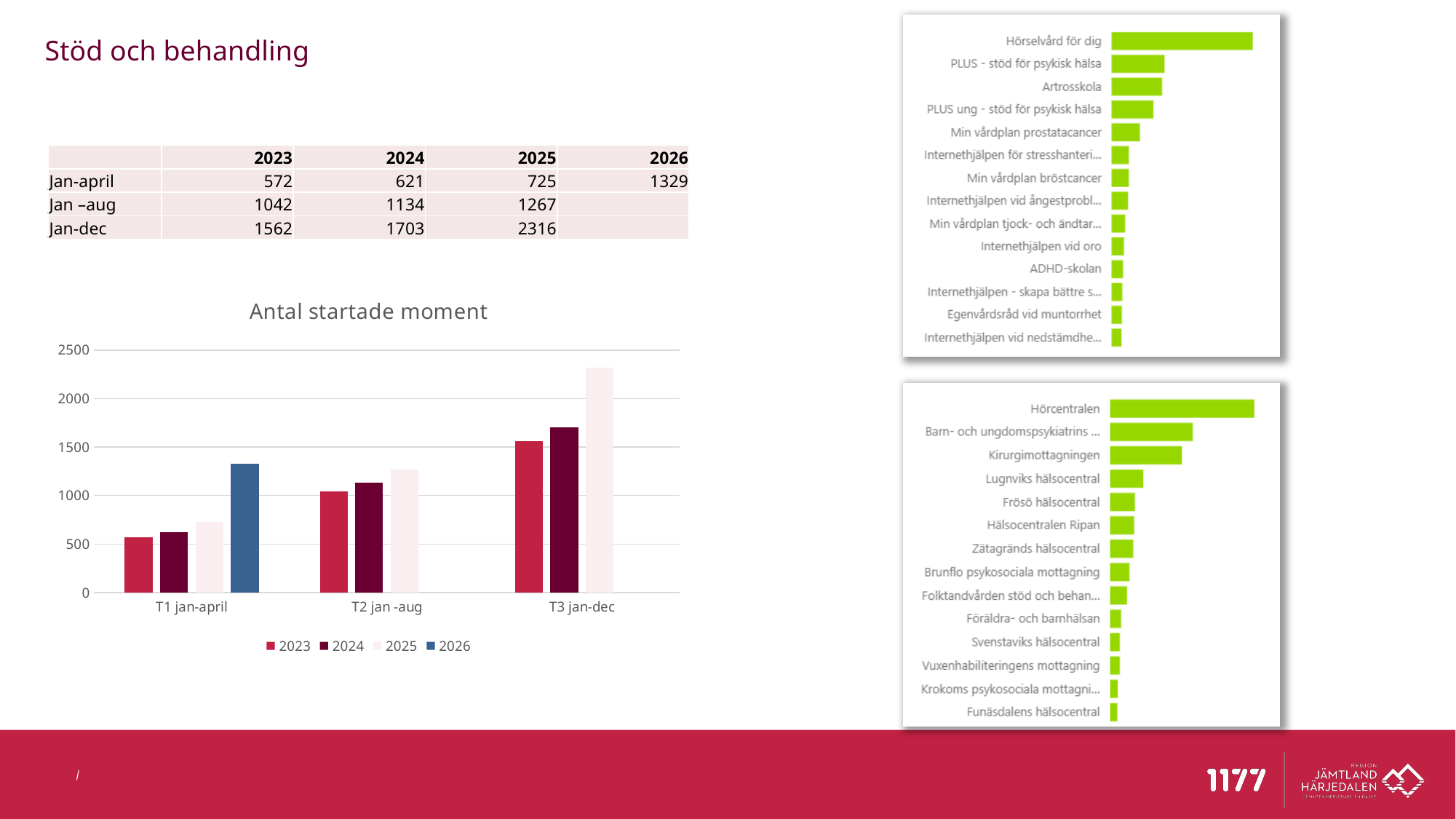
In the 'Antal startade moment' chart, what is the difference between 2025 and 2024 in T3 jan-dec? 613 In the 'Antal startade moment' chart, which year has the lowest value in T1 jan-april? 2023 In the 'Antal startade moment' chart, what kind of chart is it? bar chart In the 'Antal startade moment' chart, which year has the highest value in T3 jan-dec? 2025 In the bottom-right bar chart, which category has the longest bar? Hörcentralen In the 'Antal startade moment' chart, what is the value for 2026 in T1 jan-april? 1329 In the 'Antal startade moment' chart, how many series does the legend list? 4 In the 'Antal startade moment' chart, do the 2023 values rise or fall from T1 jan-april to T3 jan-dec? rise In the top-right bar chart, which category has the longest bar? Hörselvård för dig In the 'Antal startade moment' chart, how many categories are shown on the x axis? 3 In the 'Antal startade moment' chart, is the value for 2025 in T2 jan-aug greater or less than 1000? greater In the 'Antal startade moment' chart, what is the value for 2025 in T3 jan-dec? 2316